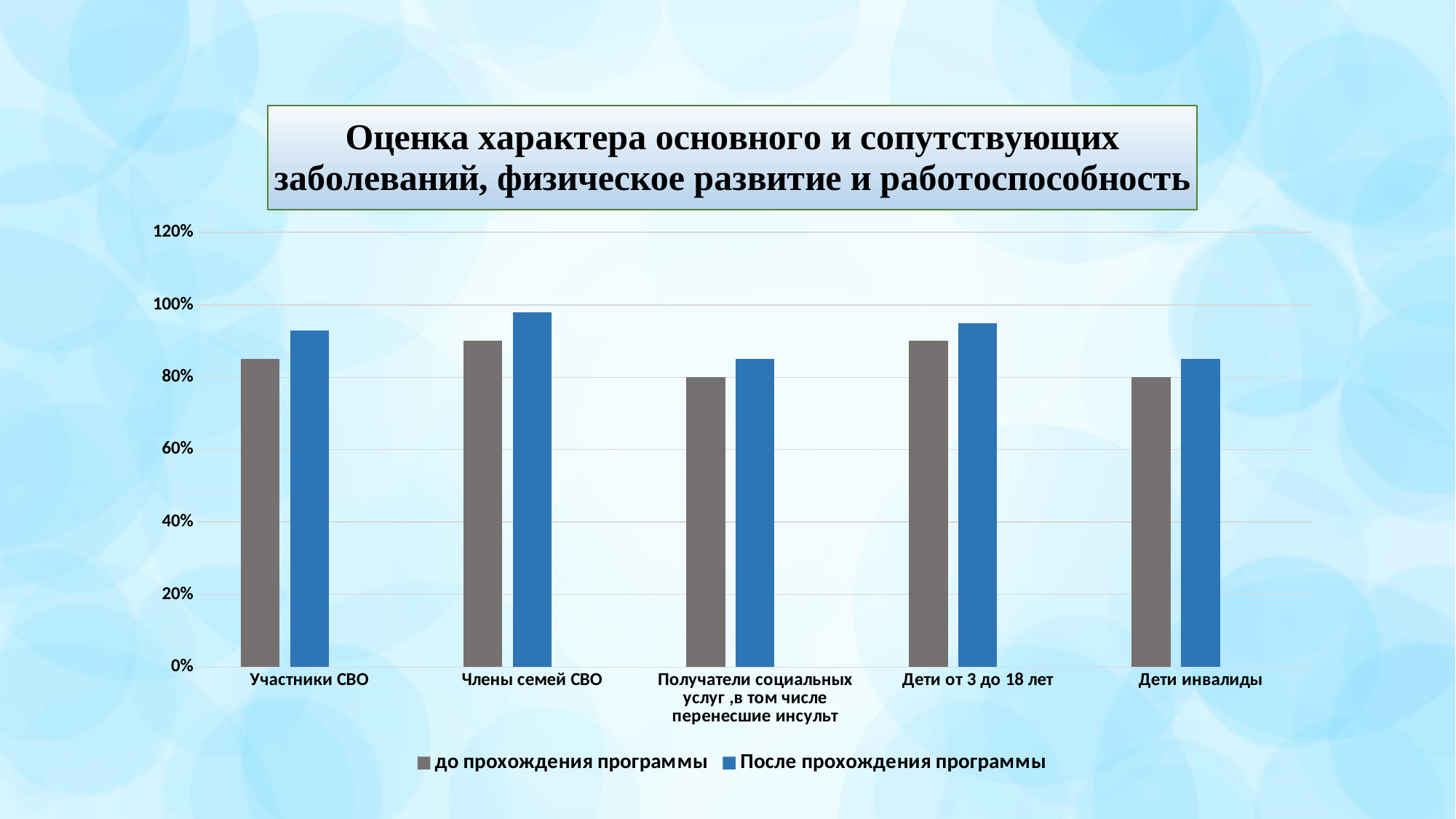
Which series is shown in blue in the chart? После прохождения программы In the series 'до прохождения программы', which is larger: Участники СВО or Члены семей СВО? Члены семей СВО Is the value for Члены семей СВО in the series 'После прохождения программы' greater or less than 100%? less Is the value for Участники СВО in the series 'После прохождения программы' greater or less than 80%? greater How many series does the chart legend list? 2 Which category has the highest value in the series 'После прохождения программы'? Члены семей СВО Which series is shown in grey in the chart? до прохождения программы Is the value for Дети инвалиды in the series 'После прохождения программы' greater or less than 100%? less For Получатели социальных услуг, в том числе перенесшие инсульт, which series has the larger value: 'до прохождения программы' or 'После прохождения программы'? После прохождения программы How many categories are shown on the x axis of the chart? 5 What kind of chart is shown on the slide? bar chart